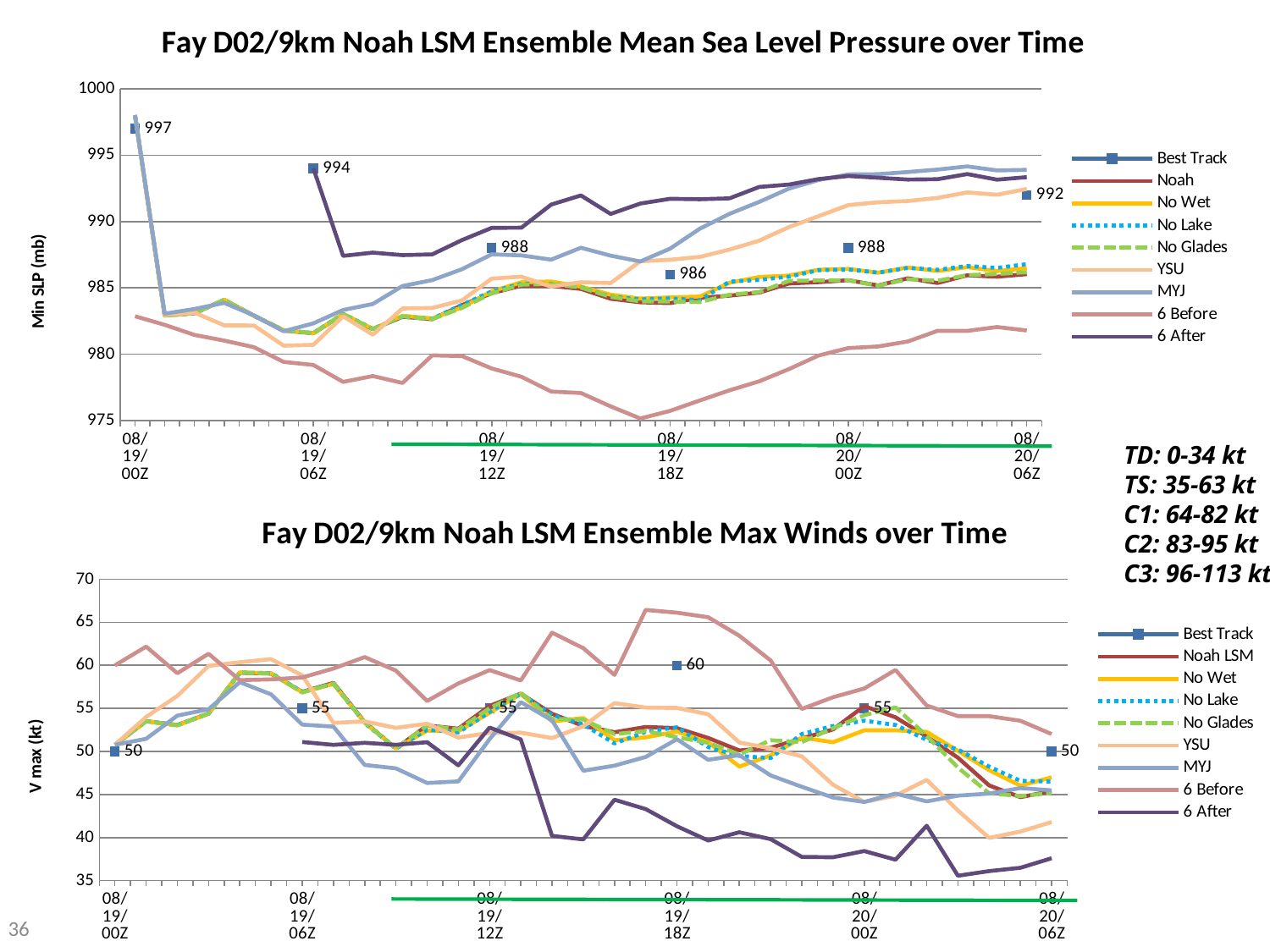
In the Max Winds chart (bottom), is the 6 After value at 08/20/00Z greater or less than 40? less In the Mean Sea Level Pressure chart (top), what is the difference between the Best Track values at 08/19/00Z and 08/19/18Z? 11 In the Mean Sea Level Pressure chart (top), what is the Best Track value at 08/19/18Z? 986 In the Max Winds chart (bottom), what is the Best Track value at 08/19/18Z? 60 In the Mean Sea Level Pressure chart (top), is the 6 Before value at 08/19/18Z greater or less than 980? less In the Max Winds chart (bottom), which labeled Best Track value is the highest? 60 In the Mean Sea Level Pressure chart (top), what is the Best Track value at 08/19/00Z? 997 In the Mean Sea Level Pressure chart (top), which labeled Best Track value is the lowest? 986 How many series does the legend of the Mean Sea Level Pressure chart (top) list? 9 In the Max Winds chart (bottom), what is the Best Track value at 08/20/06Z? 50 In the Mean Sea Level Pressure chart (top), what is the Best Track value at 08/19/06Z? 994 What kind of chart is the Max Winds chart (bottom)? line chart